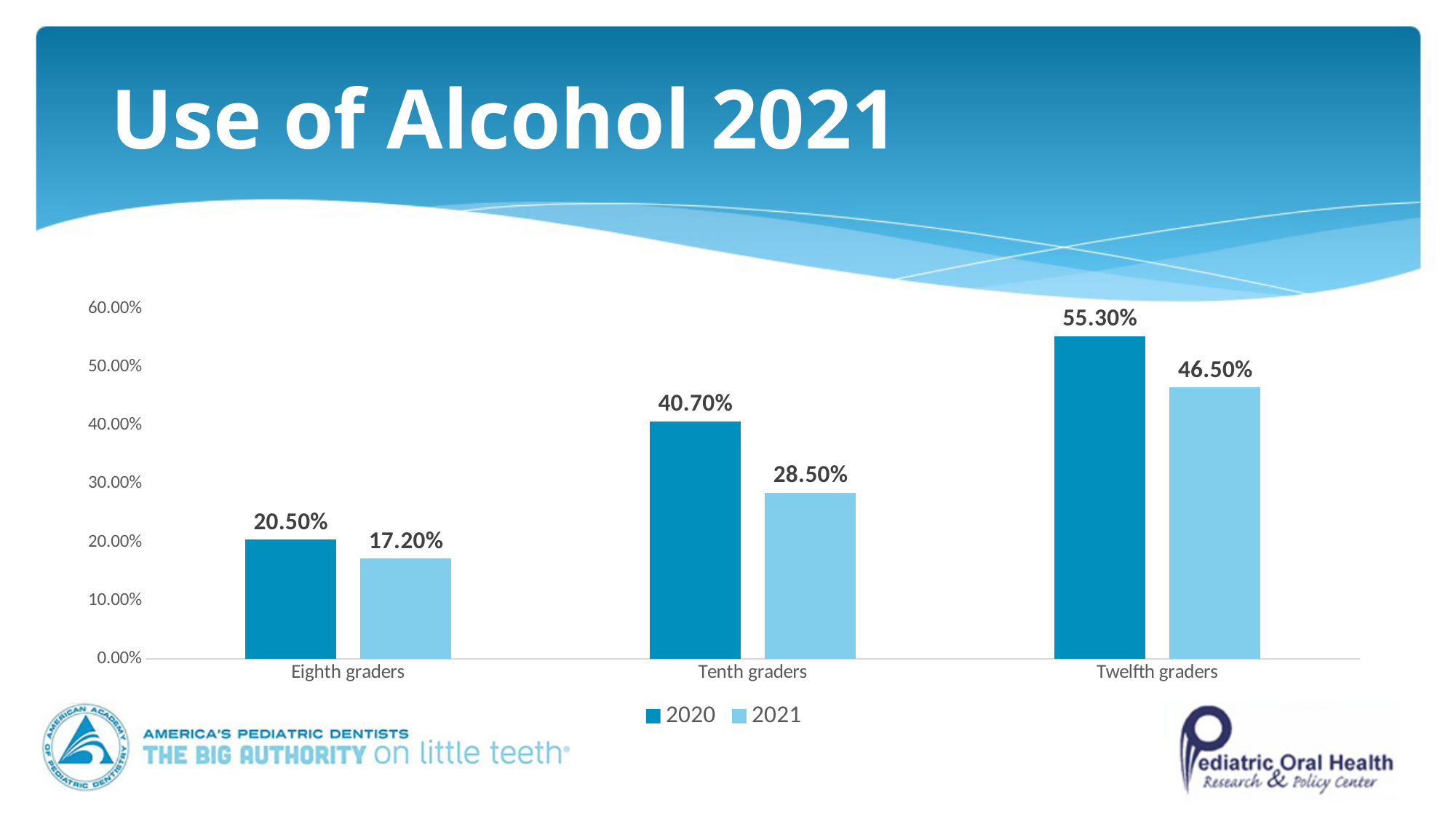
How many grade groups are shown on the x axis? 3 What is the difference between the 2020 and 2021 values for Twelfth graders? 8.80% What is the 2021 value for Twelfth graders? 46.50% Do the 2021 values rise or fall from Eighth graders to Twelfth graders? Rise What is the 2021 value for Eighth graders? 17.20% What kind of chart is shown on the slide? Bar chart What is the 2020 value for Tenth graders? 40.70% Which grade group has the lowest 2021 value? Eighth graders Which grade group has the highest 2020 value? Twelfth graders What is the difference between the 2020 and 2021 values for Tenth graders? 12.20% Which is larger: the 2021 value for Tenth graders or the 2020 value for Eighth graders? 2021 value for Tenth graders How many series does the legend list? 2